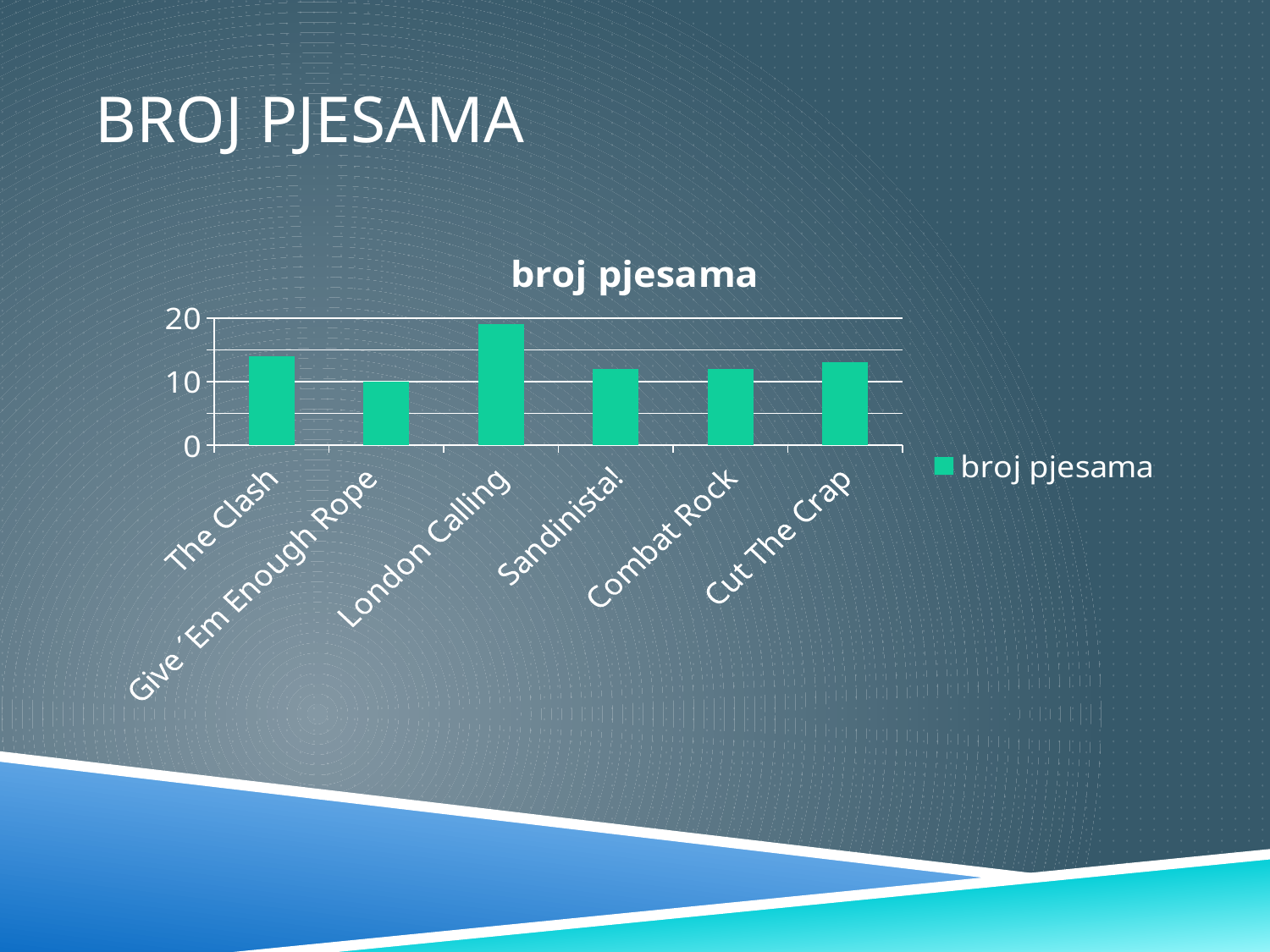
Is the value for London Calling greater or less than 15? greater Which album has the lowest number of songs in the chart? Give ´Em Enough Rope Is the value for Sandinista! greater or less than 10? greater What is the title of the chart? broj pjesama How many albums (categories) are shown on the x axis of the chart? 6 How many series does the chart legend list? 1 Is the value for Cut The Crap greater or less than 15? less Which has more songs, London Calling or The Clash? London Calling Which has more songs, The Clash or Give ´Em Enough Rope? The Clash What type of chart is shown on the slide? bar chart Which album has the highest number of songs in the chart? London Calling